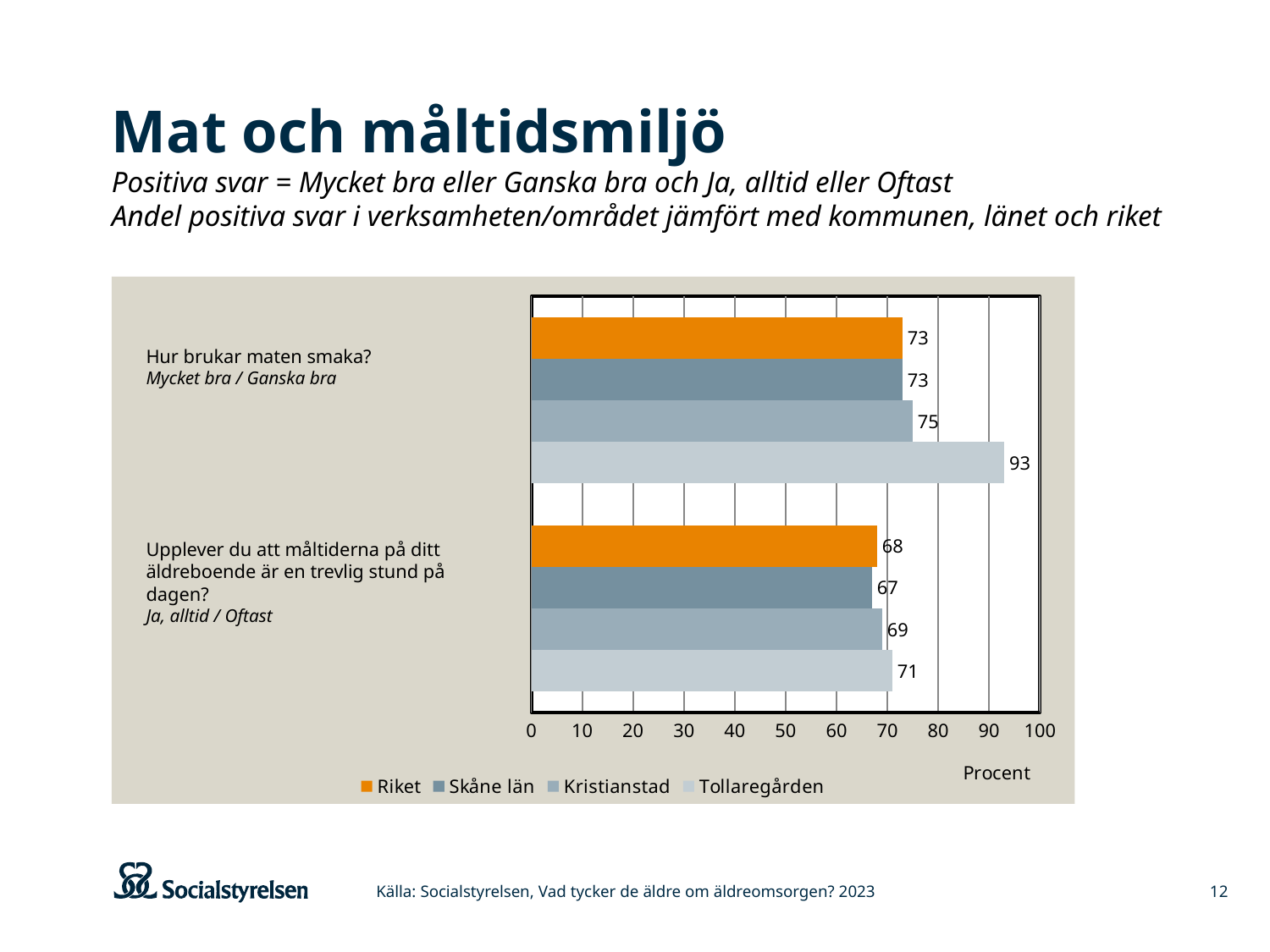
What is the value for Riket for the question "Upplever du att måltiderna på ditt äldreboende är en trevlig stund på dagen?"? 68 What is the value for Tollaregården for the question "Hur brukar maten smaka?"? 93 Which is larger for Tollaregården: the value for "Hur brukar maten smaka?" or the value for "Upplever du att måltiderna på ditt äldreboende är en trevlig stund på dagen?"? Hur brukar maten smaka? What is the difference between Tollaregården and Riket for the question "Hur brukar maten smaka?"? 20 What is the difference between Tollaregården and Kristianstad for the question "Upplever du att måltiderna på ditt äldreboende är en trevlig stund på dagen?"? 2 Which series has the lowest value for the question "Upplever du att måltiderna på ditt äldreboende är en trevlig stund på dagen?"? Skåne län What kind of chart is shown on the slide? Bar chart What is the value for Kristianstad for the question "Hur brukar maten smaka?"? 75 What is the value for Skåne län for the question "Upplever du att måltiderna på ditt äldreboende är en trevlig stund på dagen?"? 67 How many series does the legend list? 4 What is the label of the x axis? Procent Which series has the highest value for the question "Hur brukar maten smaka?"? Tollaregården